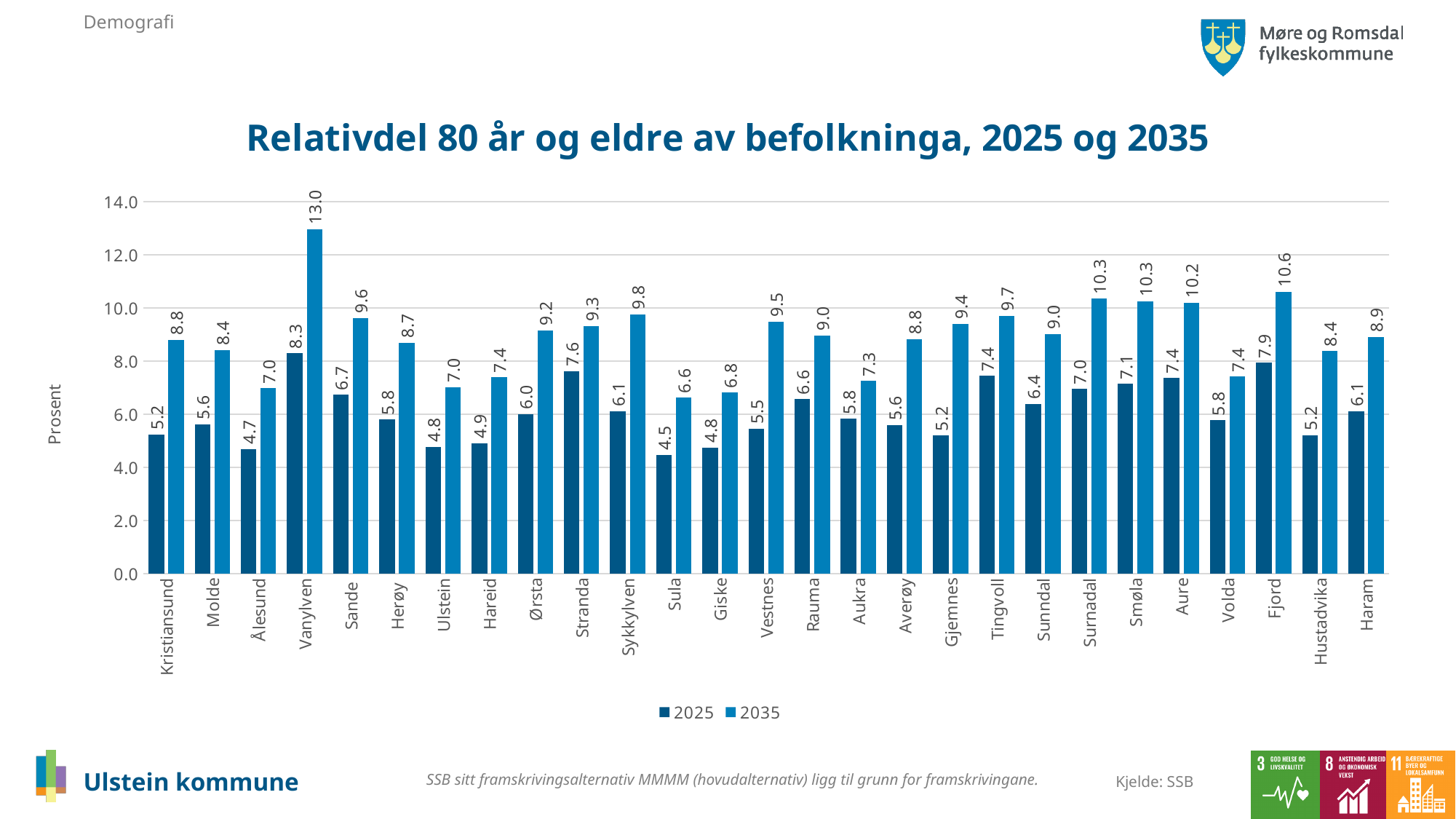
What type of chart is shown? Bar chart How many municipalities are shown on the x axis? 27 What is the 2035 value for Vanylven? 13.0 Which municipality has the lowest 2025 value? Sula How many series does the legend list? 2 Is the 2035 value for Surnadal greater or less than 10.0? greater What is the 2025 value for Ulstein? 4.8 Which municipality has the highest 2035 value? Vanylven What is the difference between the 2035 values for Vanylven and Sula? 6.4 Which is larger, the 2025 value for Stranda or the 2025 value for Tingvoll? Stranda What is the 2035 value for Fjord? 10.6 What is the difference between the 2035 and 2025 values for Ulstein? 2.2